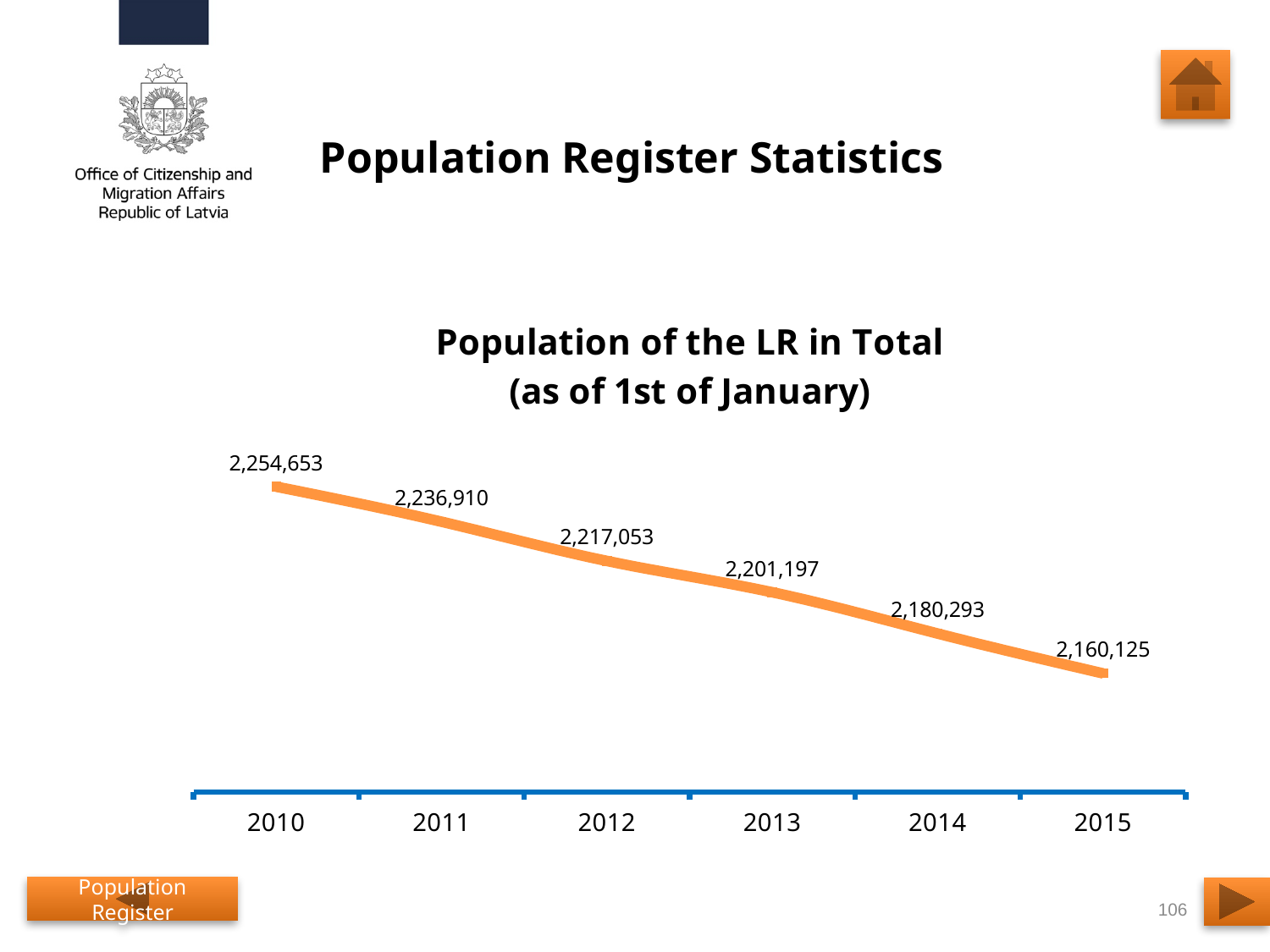
What was the population of the LR as of 1st of January 2013? 2,201,197 Which year had a larger population, 2011 or 2014? 2011 In which year was the population of the LR lowest? 2015 By how much did the population of the LR decrease between 2010 and 2015? 94,528 What is the difference between the population in 2013 and in 2014? 20,904 What kind of chart is shown on the slide? Line chart In which year was the population of the LR highest? 2010 How many years are plotted on the chart? 6 What was the population of the LR as of 1st of January 2012? 2,217,053 What was the population of the LR as of 1st of January 2015? 2,160,125 Does the population of the LR rise or fall from 2010 to 2015? Fall What was the population of the LR as of 1st of January 2010? 2,254,653